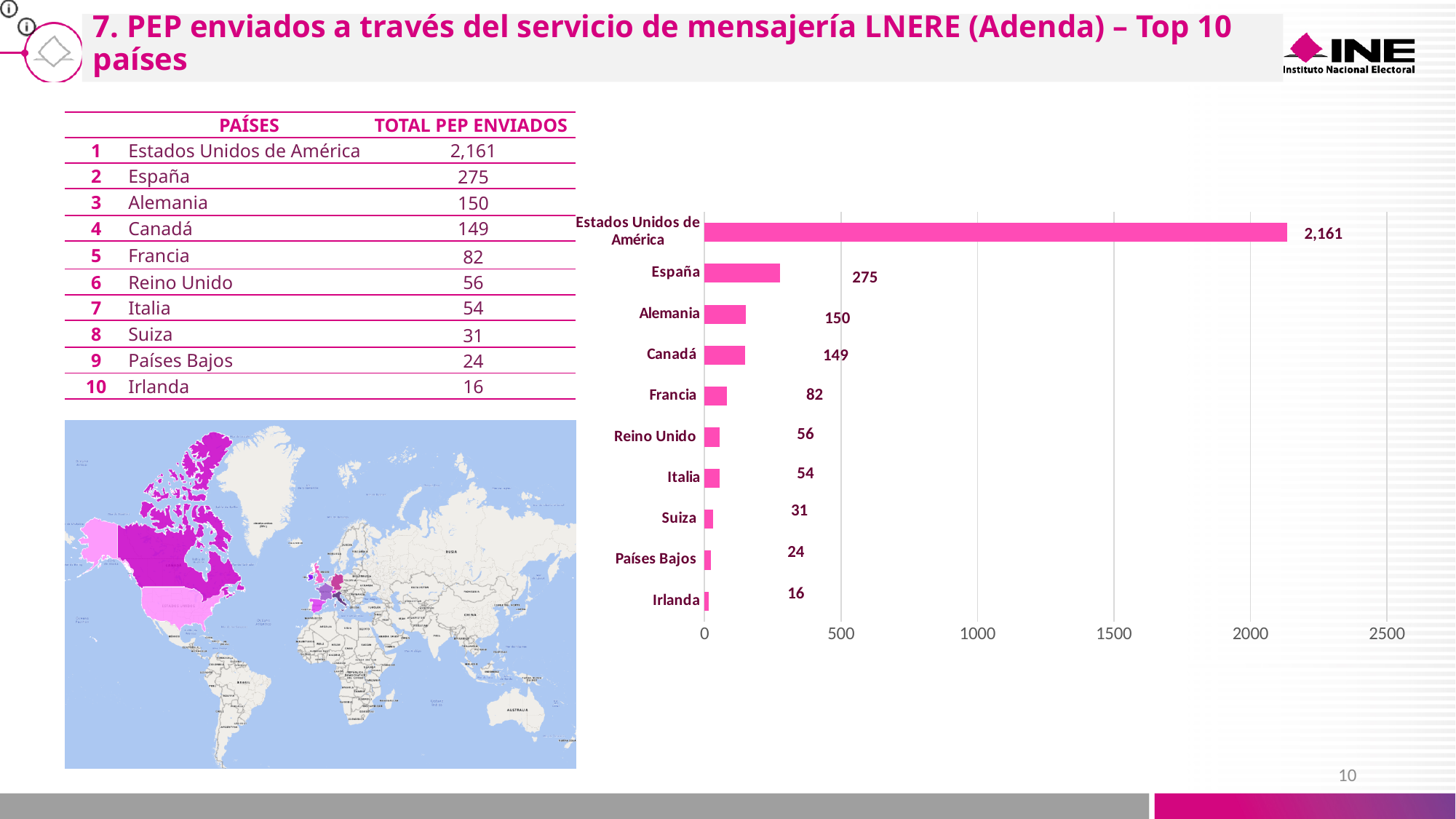
Which has a larger value in the bar chart, Reino Unido or Suiza? Reino Unido Which country has the highest value in the bar chart? Estados Unidos de América What is the value for Irlanda in the bar chart? 16 What is the difference between the values for Alemania and Canadá in the bar chart? 1 What is the value for España in the bar chart? 275 What kind of chart is shown on the right of the slide? bar chart Is the value for Estados Unidos de América in the bar chart greater or less than 2000? greater What is the value for Francia in the bar chart? 82 What is the difference between the values for Estados Unidos de América and España in the bar chart? 1,886 How many countries are shown in the bar chart? 10 Which country has the lowest value in the bar chart? Irlanda What is the highest value shown on the x axis of the bar chart? 2500